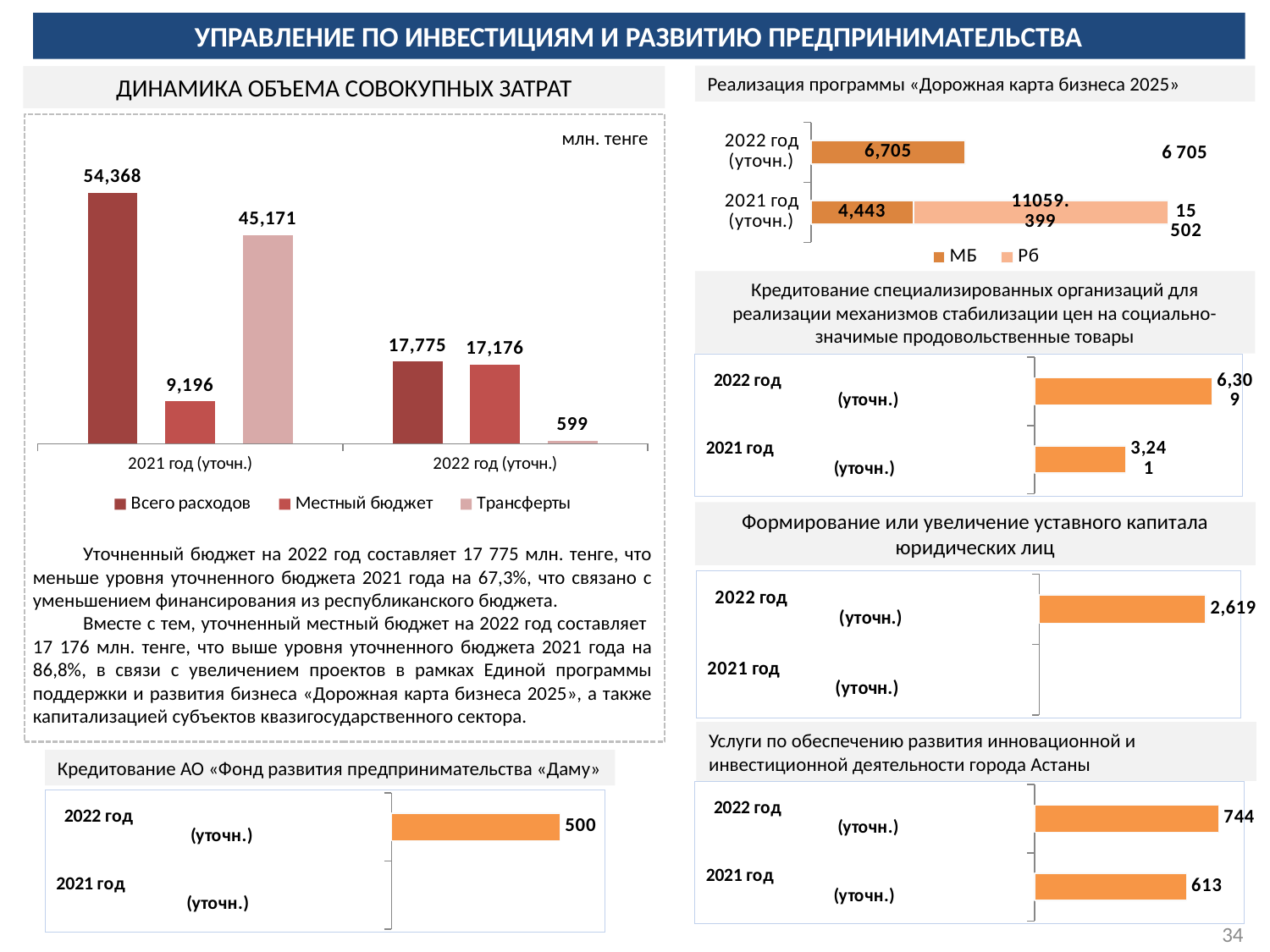
In the chart titled «ДИНАМИКА ОБЪЕМА СОВОКУПНЫХ ЗАТРАТ», what is the difference between «Всего расходов» for 2021 год (уточн.) and for 2022 год (уточн.)? 36,593 In the chart titled «Кредитование специализированных организаций для реализации механизмов стабилизации цен на социально-значимые продовольственные товары», which year has the lowest value? 2021 год (уточн.) In the chart titled «ДИНАМИКА ОБЪЕМА СОВОКУПНЫХ ЗАТРАТ», how many series does the legend list? 3 In the chart titled «ДИНАМИКА ОБЪЕМА СОВОКУПНЫХ ЗАТРАТ», what is the value of «Всего расходов» for 2021 год (уточн.)? 54,368 In the chart titled «ДИНАМИКА ОБЪЕМА СОВОКУПНЫХ ЗАТРАТ», what kind of chart is it? bar chart In the chart titled «Кредитование специализированных организаций для реализации механизмов стабилизации цен на социально-значимые продовольственные товары», what is the value for 2022 год (уточн.)? 6,309 In the chart titled «Реализация программы «Дорожная карта бизнеса 2025»», what is the total of the stacked bar for 2021 год (уточн.)? 15 502 In the chart titled «Реализация программы «Дорожная карта бизнеса 2025»», what is the value of МБ for 2021 год (уточн.)? 4,443 In the chart titled «Кредитование АО «Фонд развития предпринимательства «Даму»», what is the value for 2022 год (уточн.)? 500 In the chart titled «ДИНАМИКА ОБЪЕМА СОВОКУПНЫХ ЗАТРАТ», which is larger for 2022 год (уточн.): «Местный бюджет» or «Трансферты»? Местный бюджет In the chart titled «ДИНАМИКА ОБЪЕМА СОВОКУПНЫХ ЗАТРАТ», what is the value of «Трансферты» for 2022 год (уточн.)? 599 In the chart titled «Услуги по обеспечению развития инновационной и инвестиционной деятельности города Астаны», what is the difference between the 2022 год (уточн.) and 2021 год (уточн.) values? 131